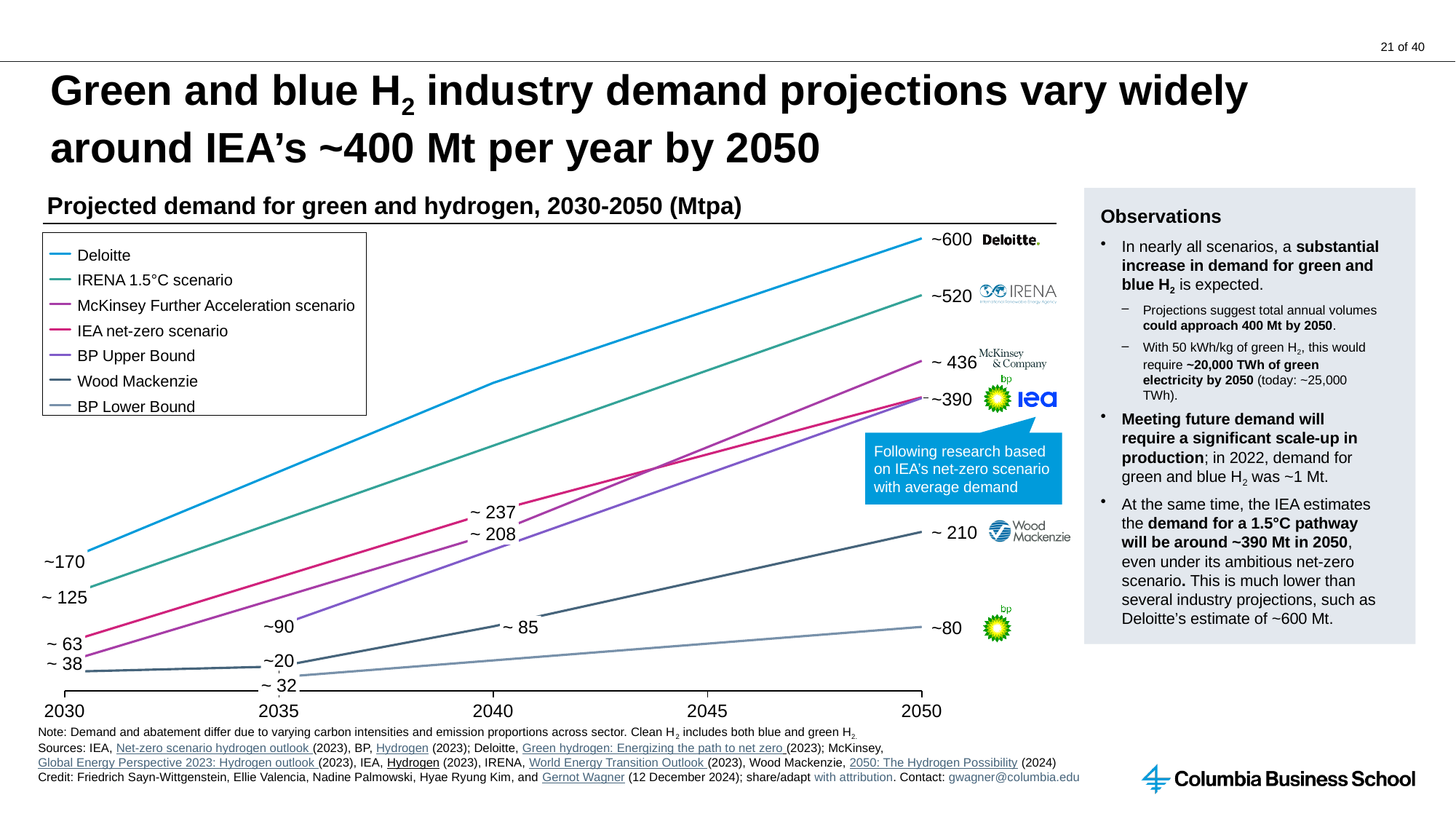
What value is labelled for Deloitte in 2050? ~600 Which series has the highest value in 2050? Deloitte In 2050, which is larger: the Deloitte value or the IRENA 1.5°C scenario value? Deloitte What value is labelled for Wood Mackenzie in 2050? ~210 How many years are labelled on the x axis? 5 In 2050, which is larger: the Wood Mackenzie value or the BP Lower Bound value? Wood Mackenzie What is the title of the chart? Projected demand for green and hydrogen, 2030-2050 (Mtpa) Which series is listed first in the legend? Deloitte Which series has the lowest value in 2050? BP Lower Bound How many series does the legend list? 7 What kind of chart is shown on the slide? line chart Does the Deloitte line rise or fall from 2030 to 2050? rise